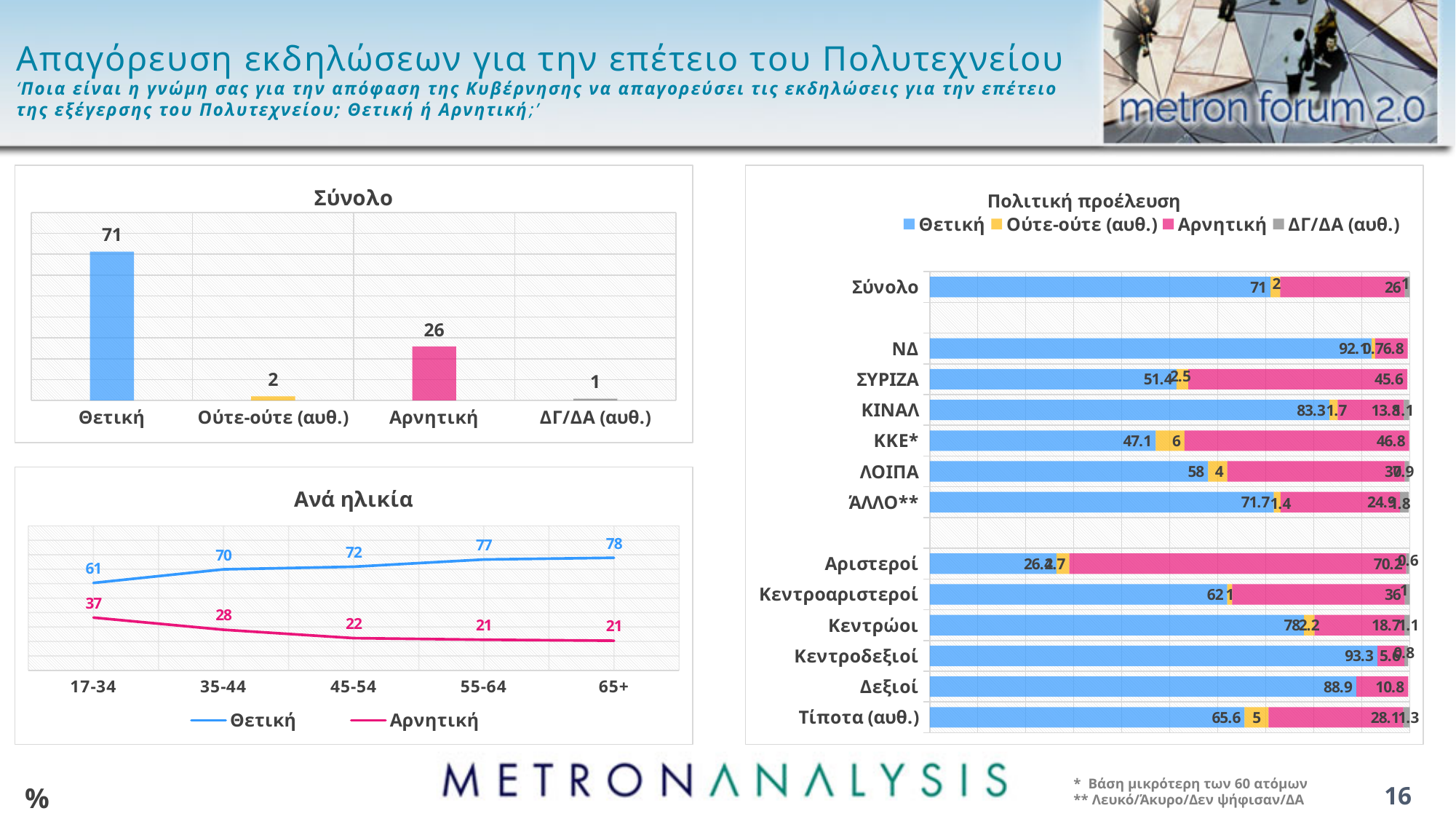
In the 'Σύνολο' chart, what is the difference between Θετική and Αρνητική? 45 In the 'Πολιτική προέλευση' chart, which of ΚΚΕ* or Κεντροαριστεροί has the larger Θετική value? Κεντροαριστεροί In the 'Ανά ηλικία' chart, what is the Θετική value for the 65+ age group? 78 What kind of chart is the 'Ανά ηλικία' chart? Line chart In the 'Ανά ηλικία' chart, which age group has the highest Αρνητική value? 17-34 In the 'Πολιτική προέλευση' chart, what is the Θετική value for ΣΥΡΙΖΑ? 51.4 In the 'Πολιτική προέλευση' chart, what is the Αρνητική value for Δεξιοί? 10.8 In the 'Σύνολο' chart, how many categories are shown? 4 In the 'Σύνολο' chart, what is the value for Θετική? 71 In the 'Ανά ηλικία' chart, does the Θετική line rise or fall from 17-34 to 65+? Rises In the 'Ανά ηλικία' chart, how many series does the legend list? 2 In the 'Σύνολο' chart, what is the value for Αρνητική? 26